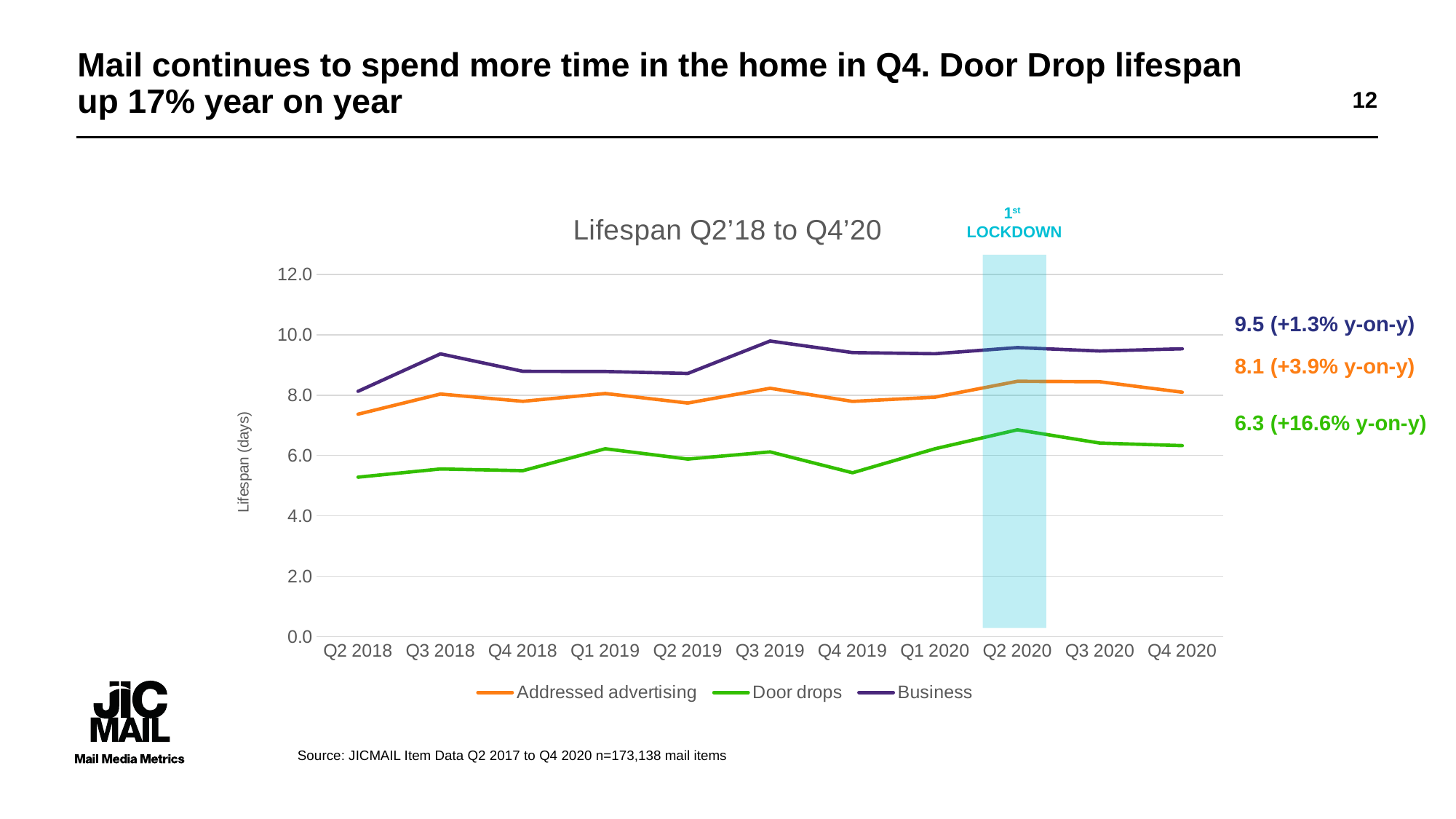
Is the Door drops value for Q4 2019 greater or less than 6.0? less What is the Business lifespan value labelled for Q4 2020? 9.5 What is the difference between the Business and Door drops values labelled for Q4 2020? 3.2 How many series does the legend list? 3 How many quarters are plotted along the x axis? 11 What is the Addressed advertising lifespan value labelled for Q4 2020? 8.1 What is the Door drops lifespan value labelled for Q4 2020? 6.3 What year-on-year change is shown for Door drops? +16.6% Is the Addressed advertising value for Q2 2018 greater or less than 8.0? less What kind of chart is shown on the slide? line chart What is the label on the y axis? Lifespan (days) Which series has the highest lifespan across all quarters shown? Business